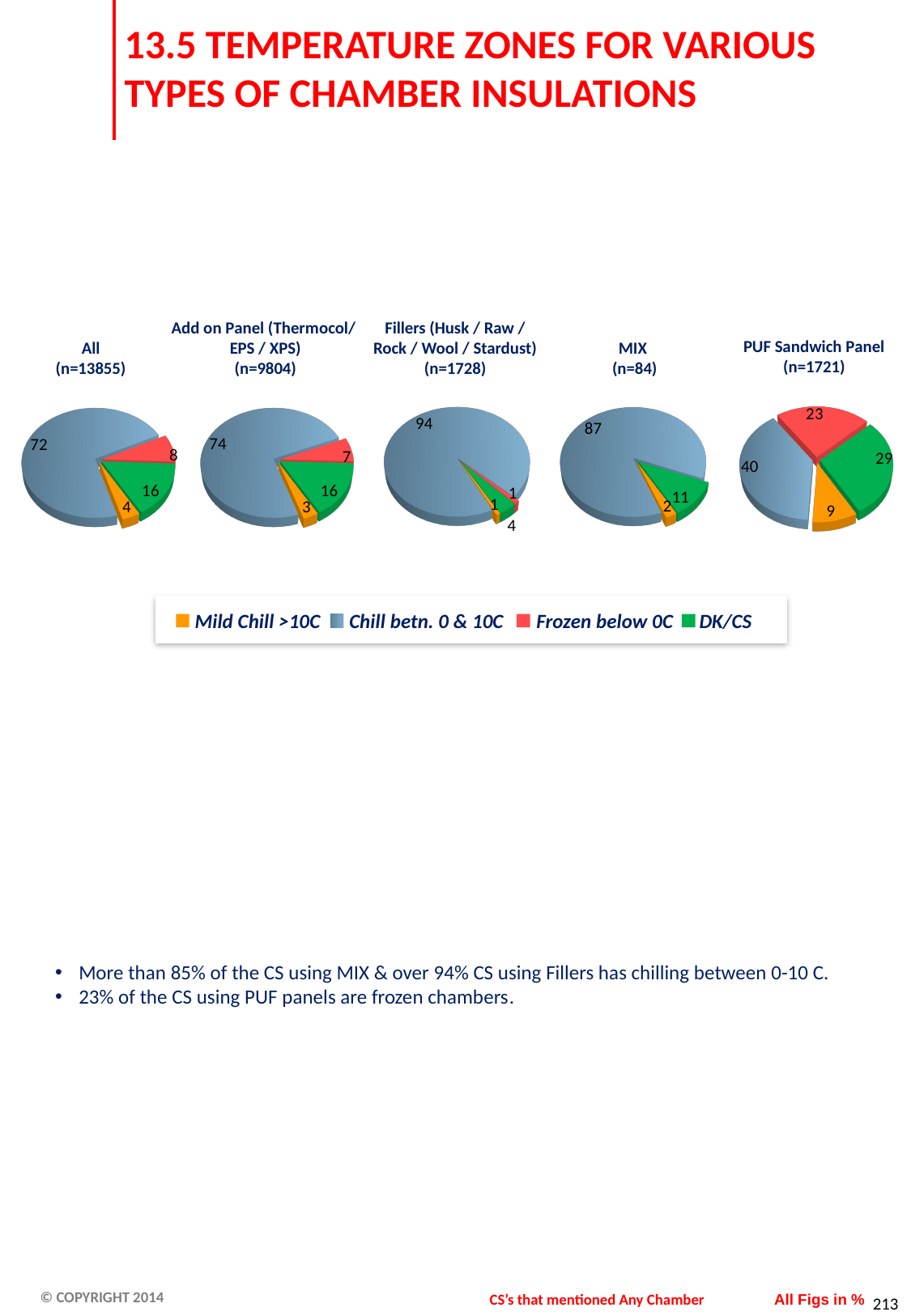
What kind of chart is used for the 'MIX (n=84)' data? Pie chart In the 'All (n=13855)' pie chart, what is the value for Chill betn. 0 & 10C? 72 In the 'Fillers (Husk / Raw / Rock / Wool / Stardust) (n=1728)' pie chart, which category has the largest share? Chill betn. 0 & 10C In the 'PUF Sandwich Panel (n=1721)' pie chart, what is the value for Frozen below 0C? 23 How many pie charts are shown on the slide? 5 In the 'MIX (n=84)' pie chart, what is the value for DK/CS? 11 In the 'PUF Sandwich Panel (n=1721)' pie chart, which is larger: DK/CS or Frozen below 0C? DK/CS How many series does the legend list? 4 In the 'PUF Sandwich Panel (n=1721)' pie chart, which category has the smallest share? Mild Chill >10C Which colour represents Mild Chill >10C in the legend? Orange In the 'All (n=13855)' pie chart, what is the difference between the DK/CS value and the Frozen below 0C value? 8 In the 'Add on Panel (Thermocol/ EPS / XPS) (n=9804)' pie chart, what is the value for Mild Chill >10C? 3